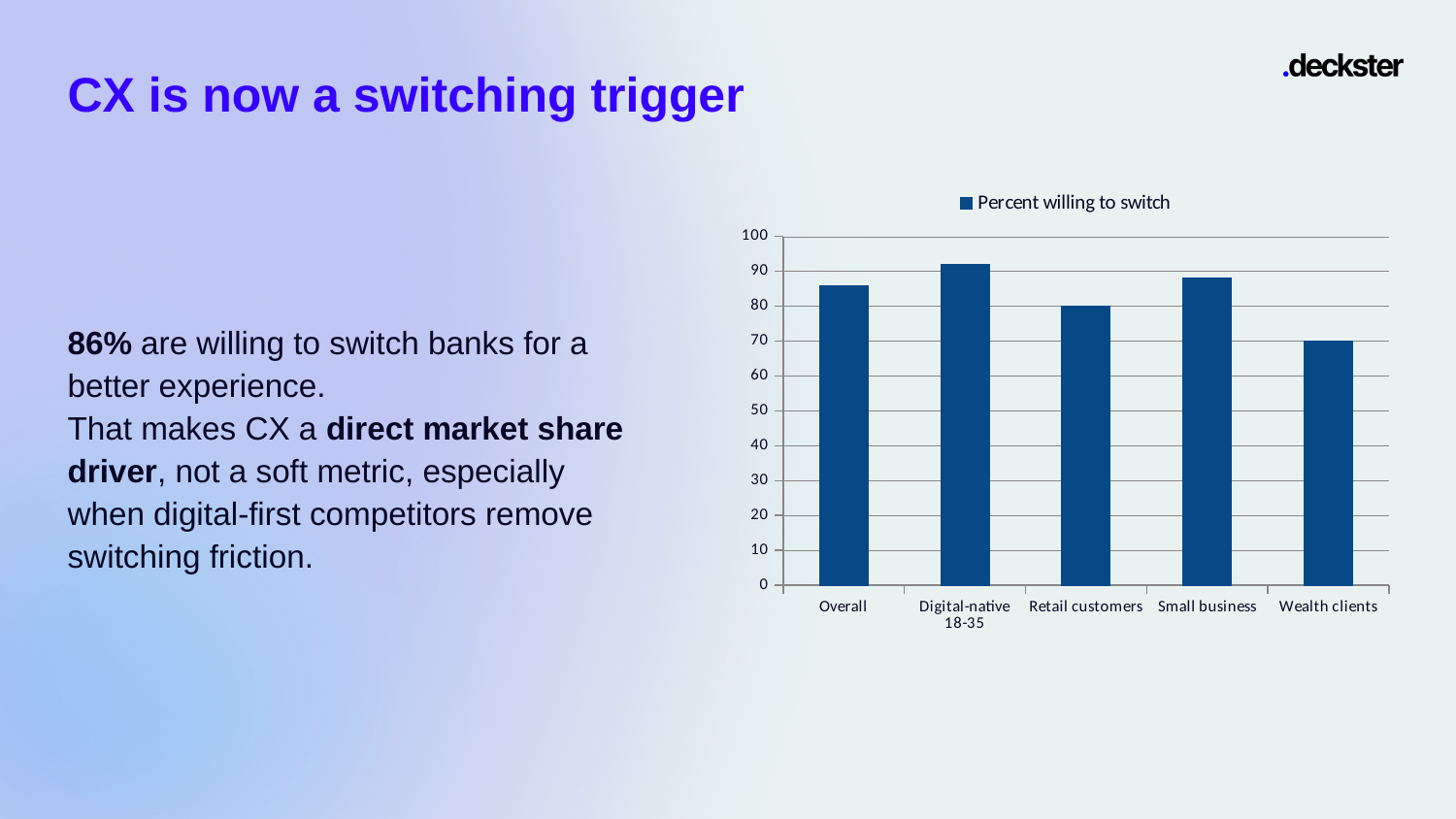
How many series does the chart legend list? 1 Is the value for Digital-native 18-35 greater or less than 90? greater Is the value for Wealth clients greater or less than 80? less Which category has the lowest value in the chart? Wealth clients Is the value for Small business greater or less than 90? less What is the name of the series shown in the chart legend? Percent willing to switch Which category has the highest value in the chart? Digital-native 18-35 How many categories are shown on the x axis of the chart? 5 Which is larger, the value for Digital-native 18-35 or the value for Retail customers? Digital-native 18-35 Which is larger, the value for Retail customers or the value for Wealth clients? Retail customers What kind of chart is shown on the slide? Bar chart